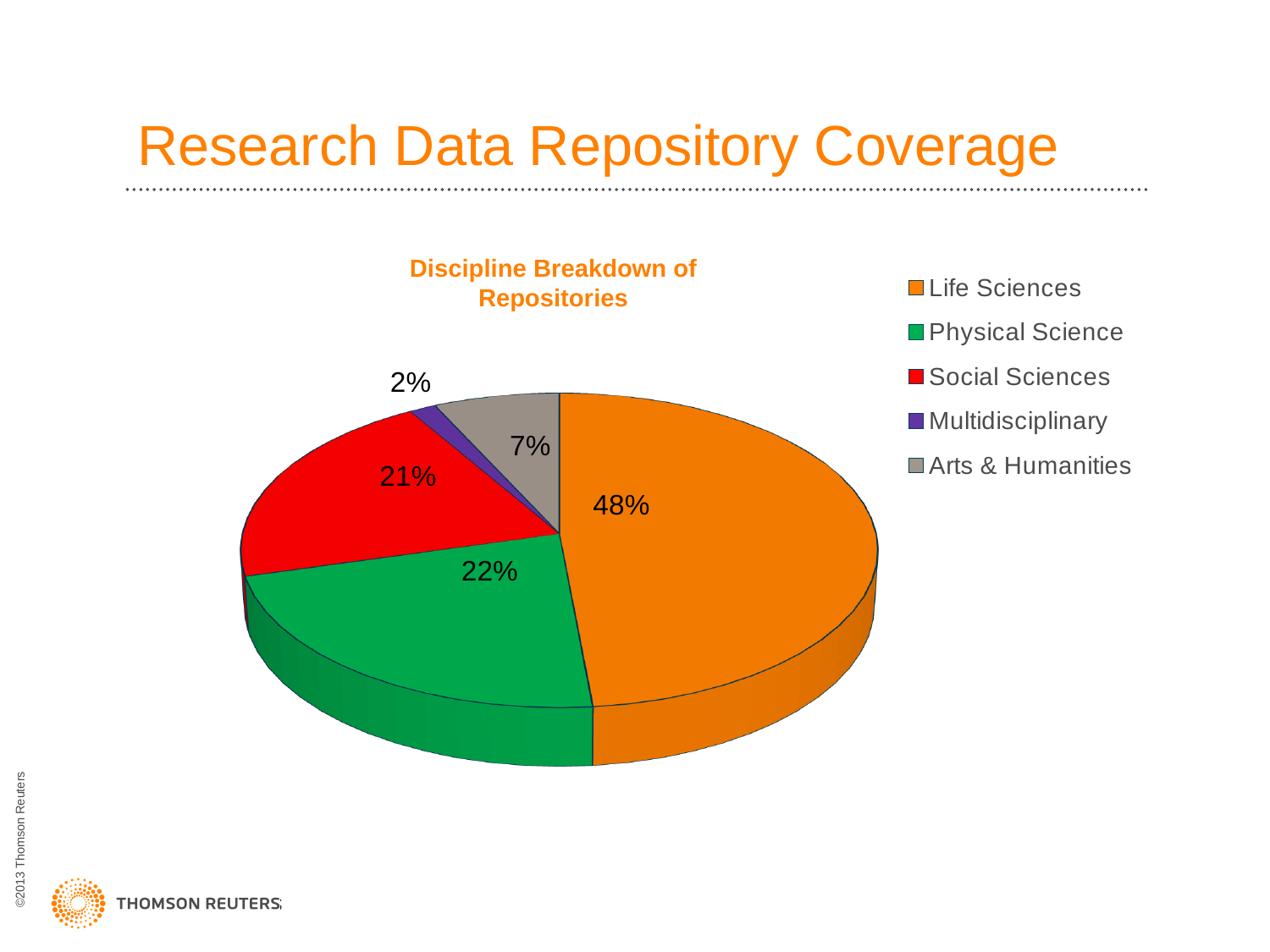
What share of repositories is Multidisciplinary? 2% What share of repositories is Life Sciences? 48% What share of repositories is Arts & Humanities? 7% What is the difference in percentage points between Life Sciences and Physical Science? 26 Which discipline has the largest share of repositories? Life Sciences What is the title of the chart? Discipline Breakdown of Repositories How many slices does the pie chart have? 5 What kind of chart is shown on the slide? Pie chart Which discipline has the smallest share of repositories? Multidisciplinary Which has a larger share, Arts & Humanities or Multidisciplinary? Arts & Humanities